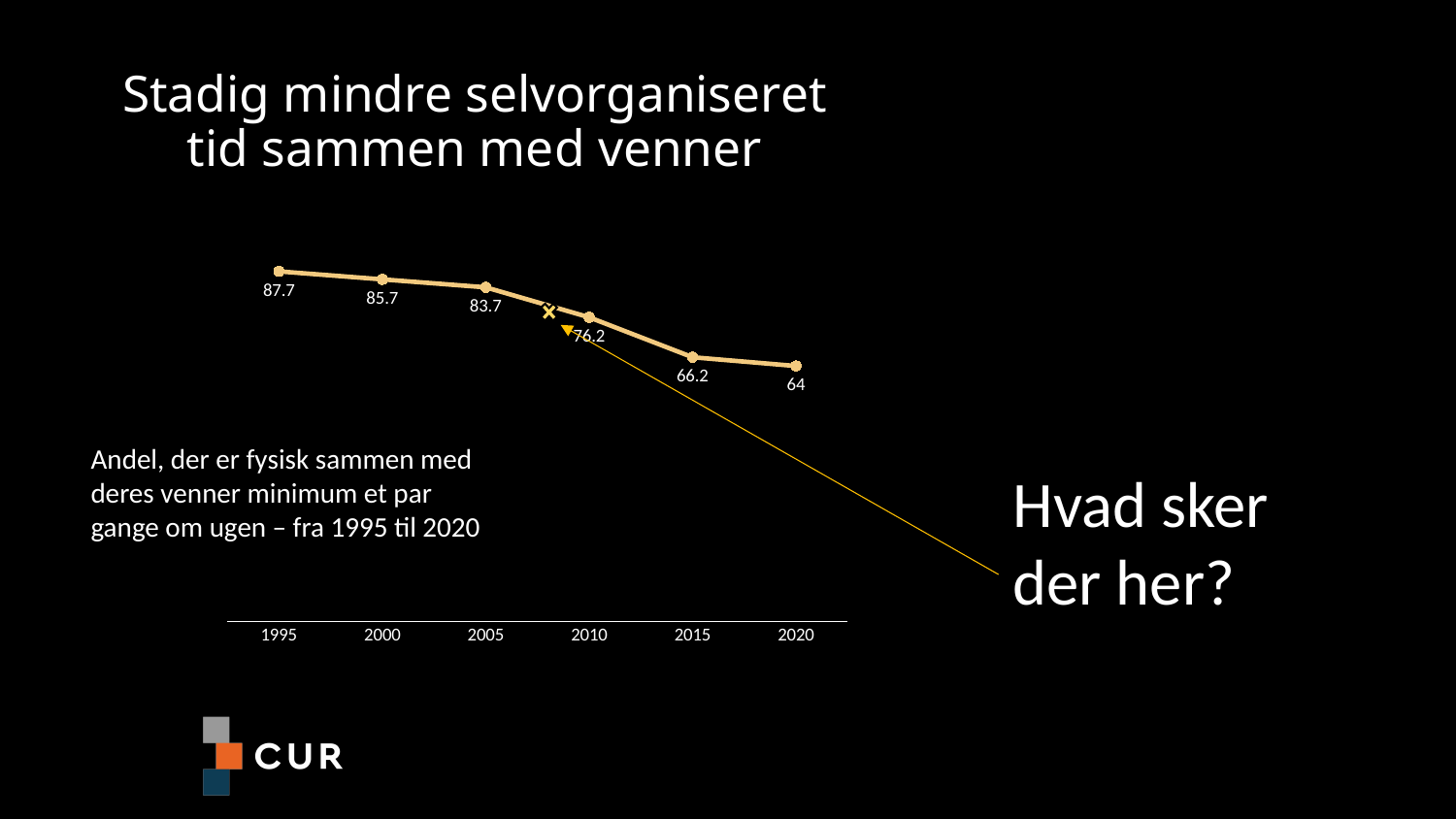
How many data points are plotted on the line? 6 What is the value for 2015? 66.2 Which year has the lowest value? 2020 What is the value for 2010? 76.2 What kind of chart is shown on the slide? line chart Do the values rise or fall from 1995 to 2020? fall What is the difference between the values for 1995 and 2020? 23.7 What is the value for 2020? 64 What is the difference between the values for 2010 and 2015? 10 Which is larger, the value for 2000 or the value for 2005? 2000 What is the value for 1995? 87.7 Which year has the highest value? 1995